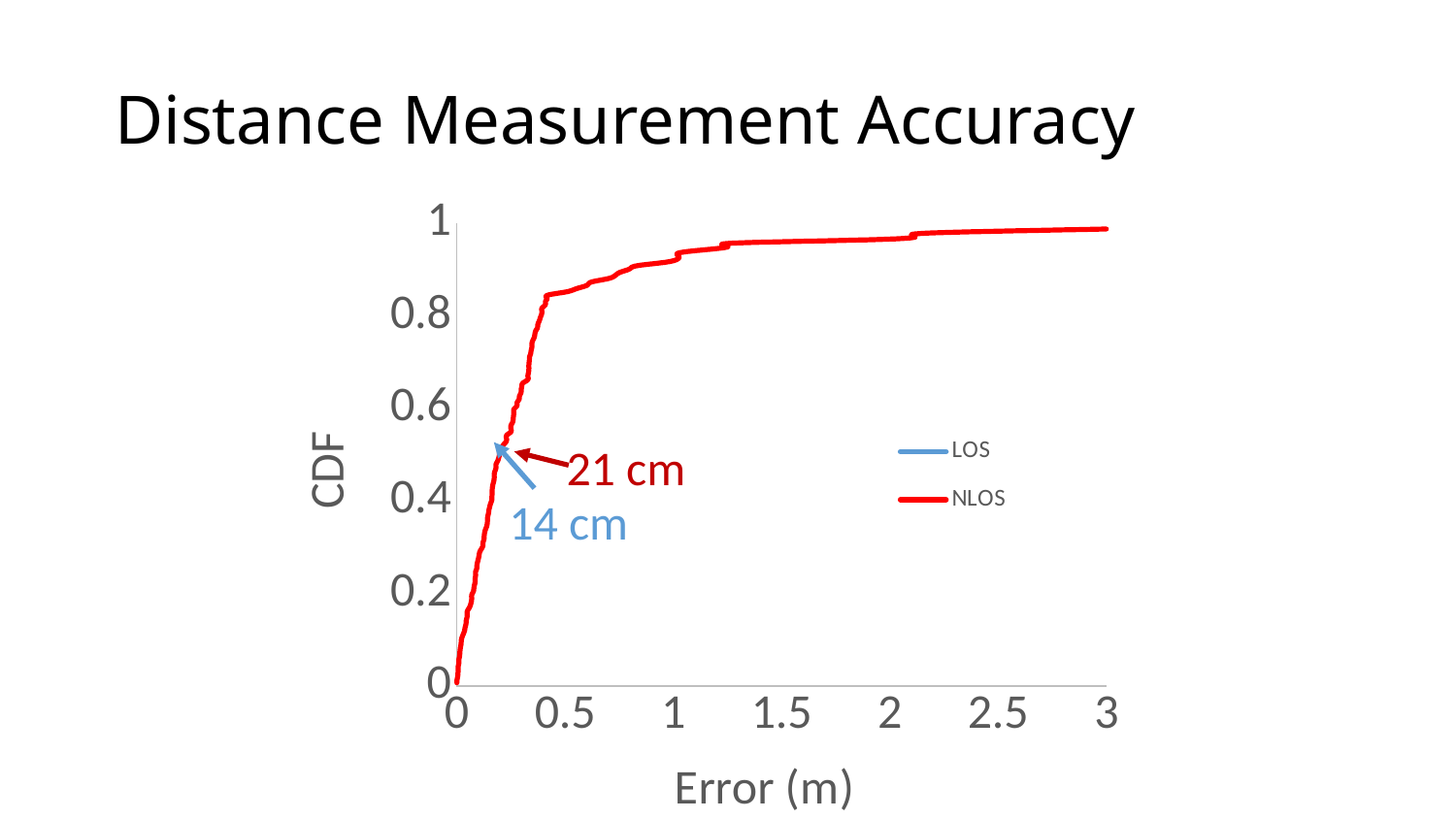
What is the largest tick value shown on the x axis? 3 Is the NLOS CDF value at an error of 1 m greater or less than 0.8? greater What value is annotated in red next to the NLOS curve? 21 cm What value is annotated in blue for the LOS curve? 14 cm What is the title of the chart? Distance Measurement Accuracy Is the NLOS CDF value at an error of 0.1 m greater or less than 0.6? less How many series does the legend list? 2 Does the NLOS curve rise or fall as Error increases along the x axis? rise What kind of chart is shown on the slide? line chart Is the NLOS CDF value at an error of 0.5 m greater or less than 0.6? greater Which annotated error value is larger, the LOS 14 cm or the NLOS 21 cm? NLOS 21 cm What is the label of the x axis? Error (m)